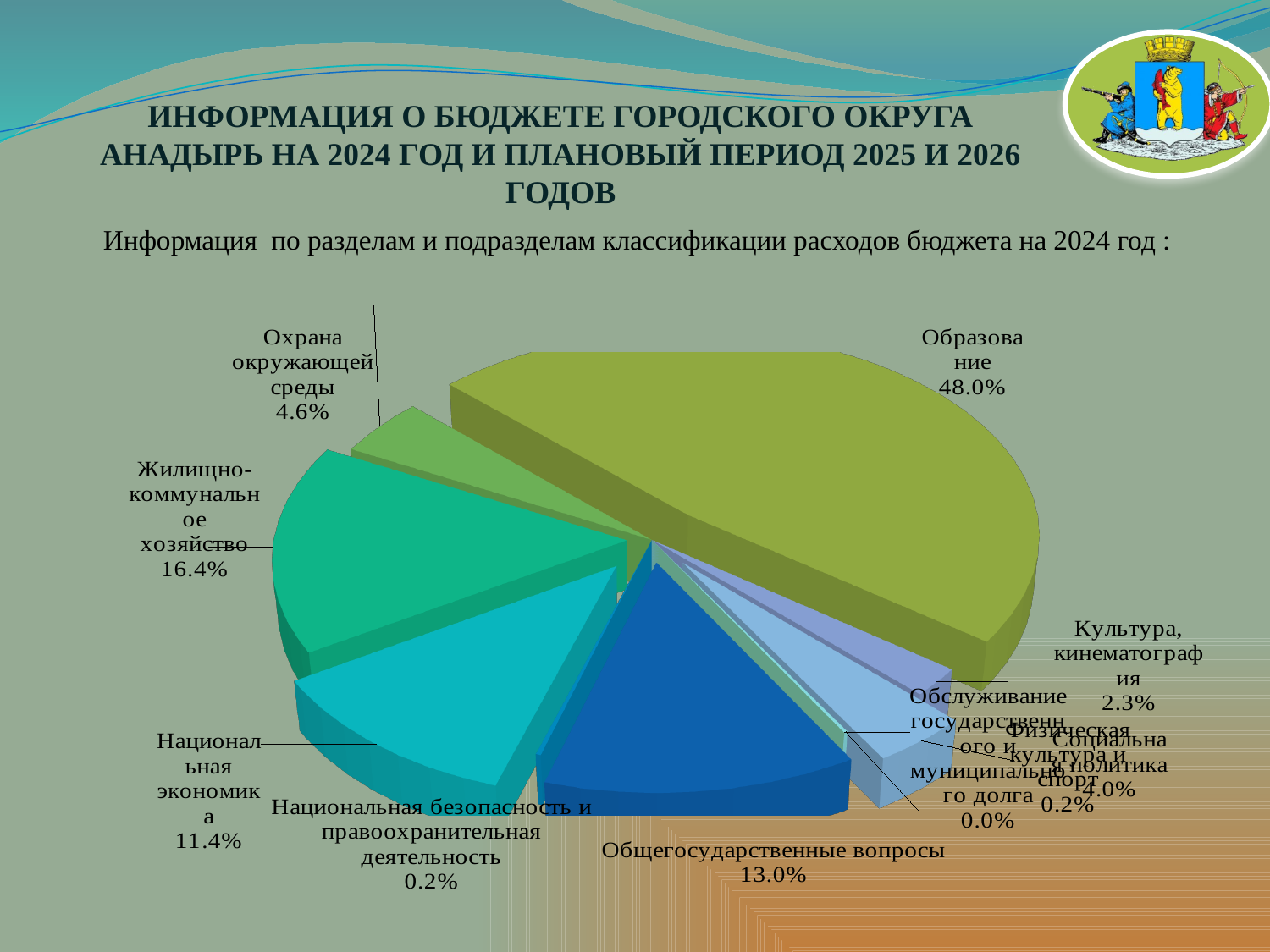
How many slices does the pie chart have? 10 What percentage is shown for Национальная экономика? 11.4% What percentage is shown for Общегосударственные вопросы? 13.0% What share of the 2024 budget expenditure goes to Образование? 48.0% What percentage is shown for Культура, кинематография? 2.3% Which year's budget expenditure does the pie chart describe? 2024 What percentage is shown for Охрана окружающей среды? 4.6% Which section has the largest share of the pie? Образование What kind of chart is shown on the slide? Pie chart By how many percentage points does the share for Образование exceed the share for Жилищно-коммунальное хозяйство? 31.6 percentage points What percentage is shown for Жилищно-коммунальное хозяйство? 16.4% Which is larger: the share for Жилищно-коммунальное хозяйство or for Общегосударственные вопросы? Жилищно-коммунальное хозяйство